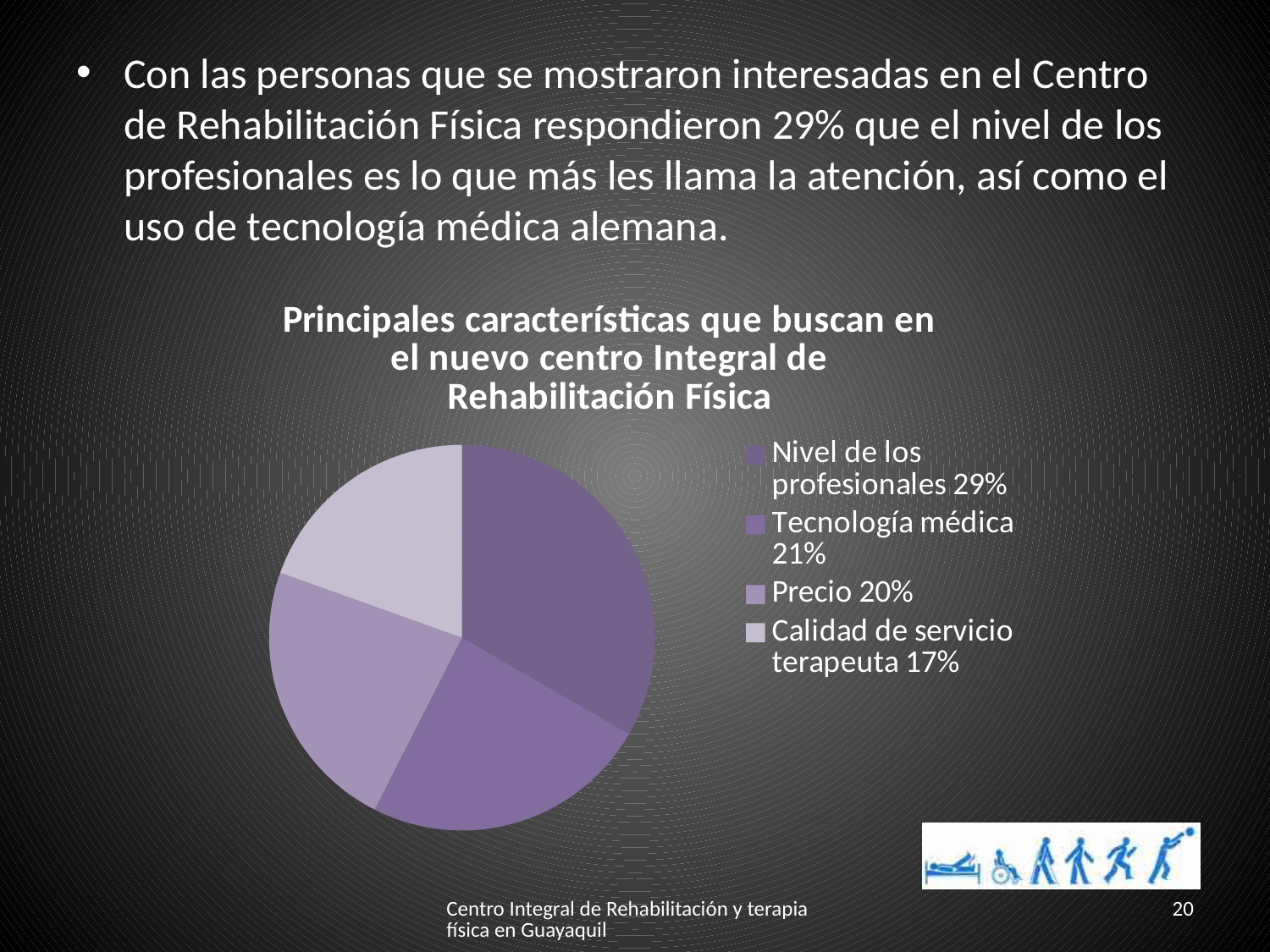
What share of the pie does "Tecnología médica" represent? 21% How many slices does the pie chart have? 4 What share of the pie does "Precio" represent? 20% What share of the pie does "Calidad de servicio terapeuta" represent? 17% How many entries does the legend of the pie chart list? 4 What kind of chart is shown on the slide? pie chart Which is larger, the share for "Tecnología médica" or the share for "Calidad de servicio terapeuta"? Tecnología médica What is the title of the pie chart? Principales características que buscan en el nuevo centro Integral de Rehabilitación Física Which category has the largest slice in the pie chart? Nivel de los profesionales What is the difference between the shares for "Nivel de los profesionales" and "Calidad de servicio terapeuta"? 12% Which category has the smallest slice in the pie chart? Calidad de servicio terapeuta